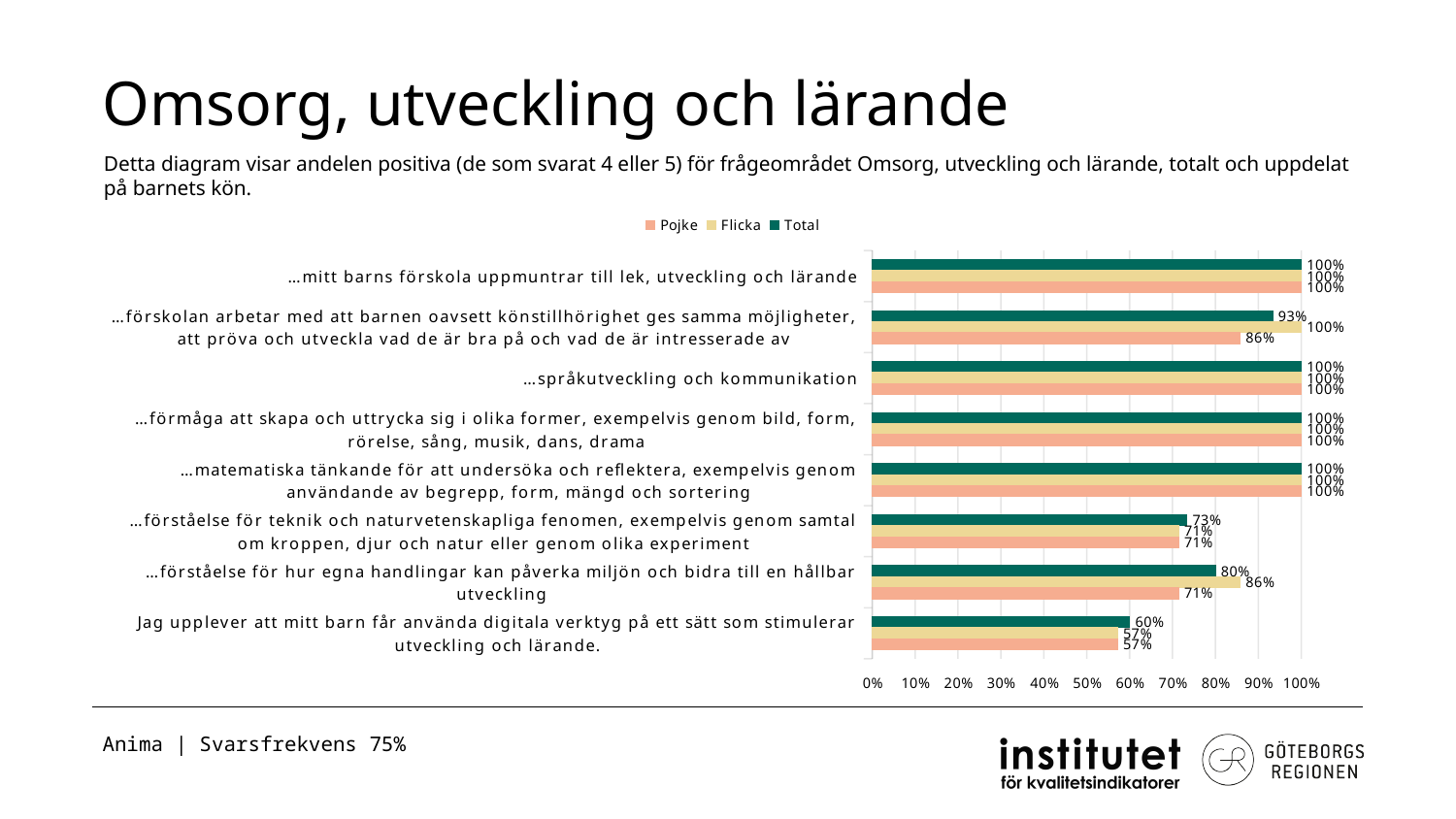
How many series does the legend list? 3 What kind of chart is shown on the slide? bar chart What is the Pojke value for "…förskolan arbetar med att barnen oavsett könstillhörighet ges samma möjligheter..."? 86% How many categories (statements) are plotted in the chart? 8 What is the difference between the Flicka and Pojke values for "…förståelse för hur egna handlingar kan påverka miljön..."? 15% Which statement has the lowest Total value? Jag upplever att mitt barn får använda digitala verktyg på ett sätt som stimulerar utveckling och lärande. For "…förskolan arbetar med att barnen oavsett könstillhörighet ges samma möjligheter...", which is larger, the Flicka value or the Pojke value? Flicka Which series is shown in dark green in the legend? Total What is the Total value for "…förståelse för teknik och naturvetenskapliga fenomen..."? 73% What is the Flicka value for "…förståelse för hur egna handlingar kan påverka miljön och bidra till en hållbar utveckling"? 86% What is the Pojke value for "…förståelse för hur egna handlingar kan påverka miljön och bidra till en hållbar utveckling"? 71% What is the Total value for the statement about digital tools ("Jag upplever att mitt barn får använda digitala verktyg...")? 60%